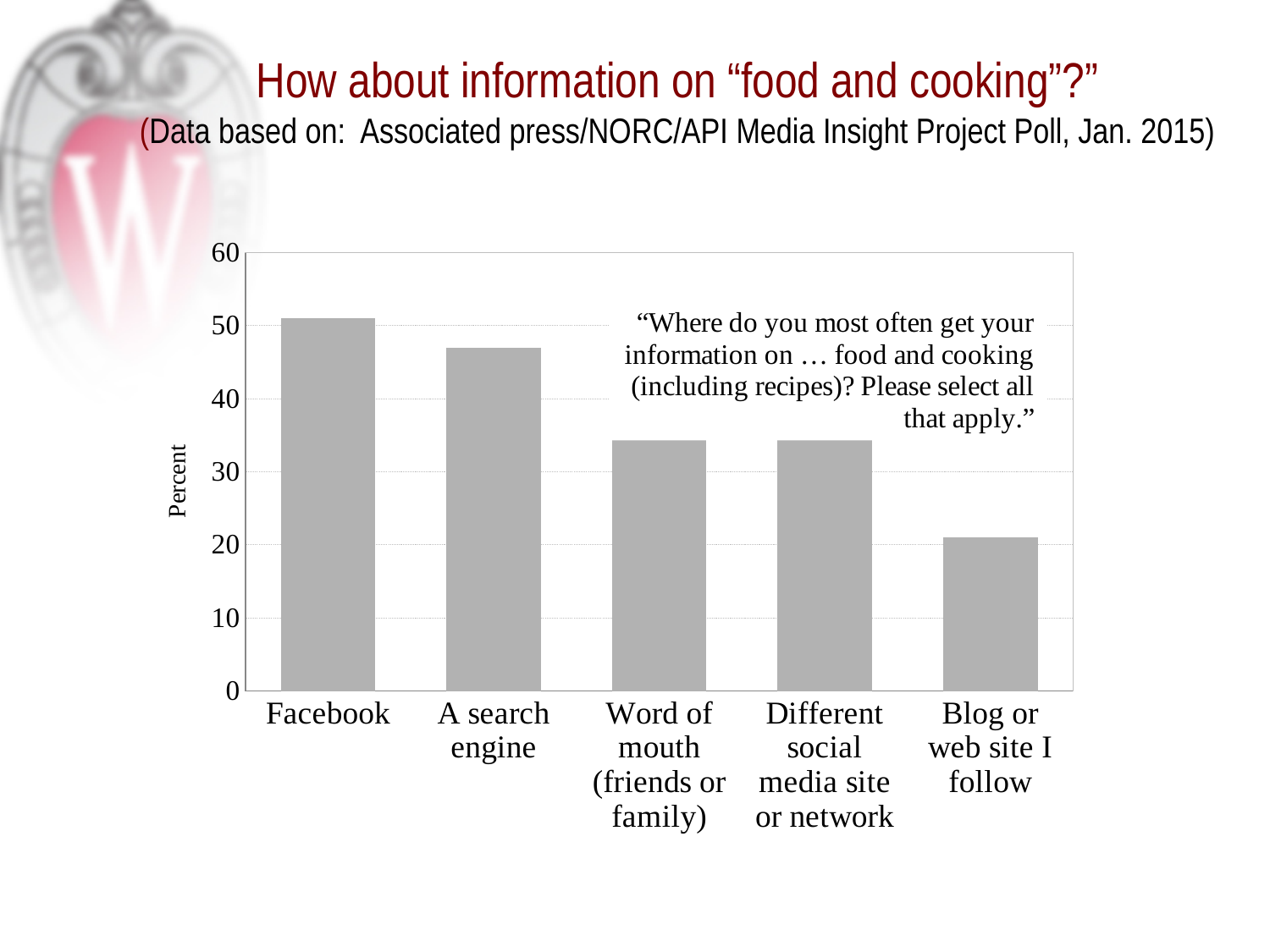
Which is larger, the value for Facebook or the value for A search engine? Facebook Which category has the lowest bar in the chart? Blog or web site I follow Which category has the highest bar in the chart? Facebook Do the bar values generally rise or fall moving from left to right along the x axis? fall What kind of chart is shown on the slide? bar chart Is the value for Different social media site or network greater or less than 30? greater Is the value for Word of mouth (friends or family) greater or less than 40? less Is the value for Facebook greater or less than 40? greater How many categories are shown on the x axis of the chart? 5 What is the label on the vertical axis of the chart? Percent